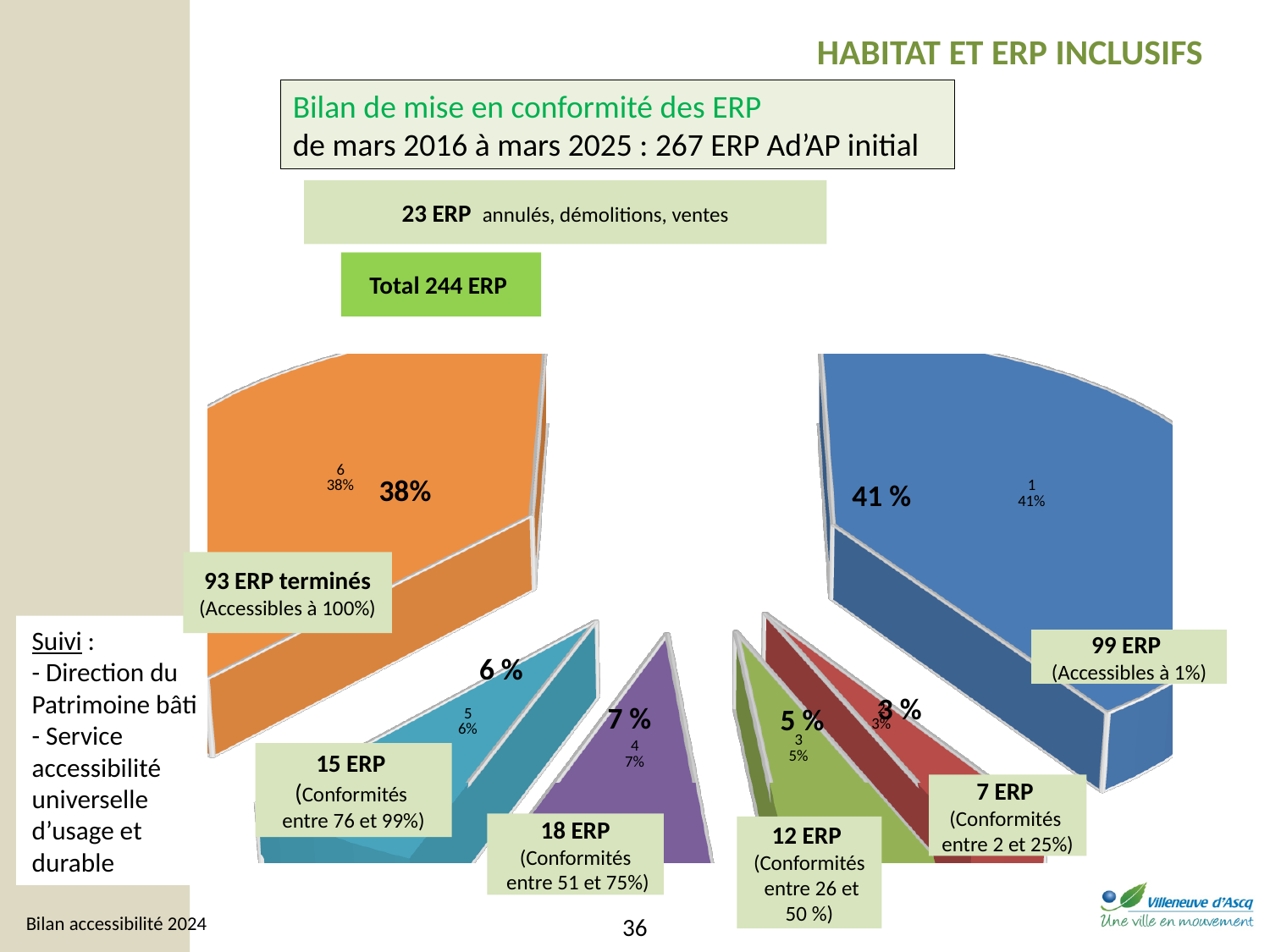
What share of the pie is labelled for the 93 ERP terminés (Accessibles à 100%) slice? 38% What share of the pie is labelled for the 99 ERP (Accessibles à 1%) slice? 41 % Which slice of the pie chart is the smallest? 7 ERP (Conformités entre 2 et 25%) How many more ERP are in the 'Accessibles à 1%' slice than in the 'terminés (Accessibles à 100%)' slice? 6 What colour is the slice for the 93 ERP terminés (Accessibles à 100%)? orange What kind of chart is shown on the slide? pie chart Which slice is larger: 15 ERP (Conformités entre 76 et 99%) or 18 ERP (Conformités entre 51 et 75%)? 18 ERP (Conformités entre 51 et 75%) Which slice of the pie chart is the largest? 99 ERP (Accessibles à 1%) How many slices does the pie chart have? 6 What percentage is labelled for the 18 ERP (Conformités entre 51 et 75%) slice? 7 % How many ERP have conformités entre 26 et 50 %? 12 ERP What is the total number of ERP represented in the pie chart, as stated on the slide? 244 ERP